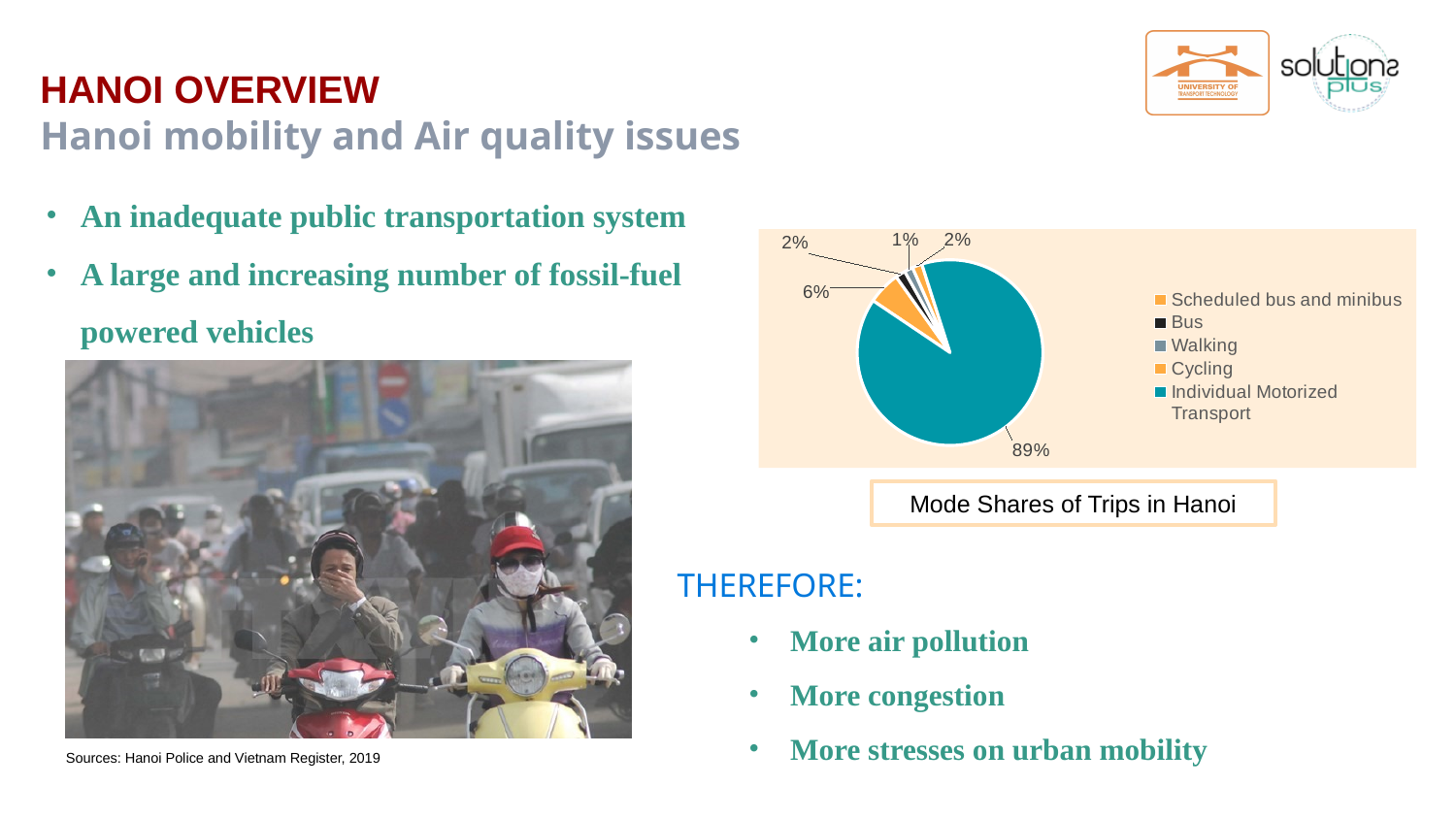
What is the title of the chart on the slide? Mode Shares of Trips in Hanoi By how many percentage points does the share of Individual Motorized Transport exceed the share of Cycling? 87 percentage points Is the share of Individual Motorized Transport greater or less than 50%? greater What share of trips in Hanoi is made by Cycling? 2% What share of trips in Hanoi is made by Individual Motorized Transport? 89% Which mode has the smallest share of trips in Hanoi? Walking How many modes of transport are shown in the pie chart? 5 What share of trips in Hanoi is made by Walking? 1% What type of chart is shown on the slide? Pie chart Which mode has the largest share of trips in Hanoi? Individual Motorized Transport What share of trips in Hanoi is made by Bus? 2%